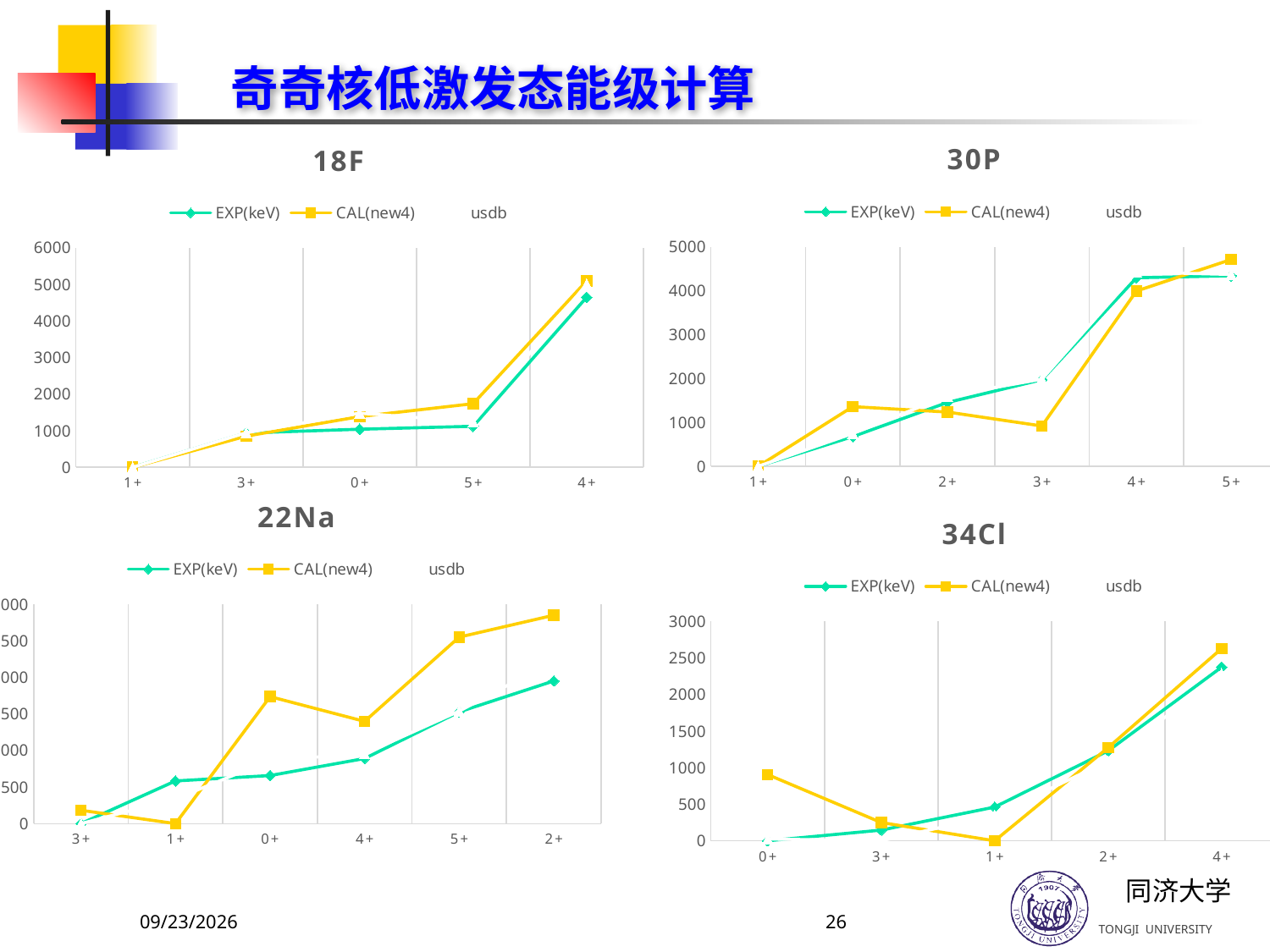
In the 18F chart, is the EXP(keV) value at 4+ greater or less than 4000? greater What kind of chart is the 18F chart? line chart In the 30P chart, at which category does the CAL(new4) series reach its highest value? 5+ In the 22Na chart, at which category does the CAL(new4) series reach its lowest value? 1+ In the 30P chart, which series has the larger value at 0+, EXP(keV) or CAL(new4)? CAL(new4) In the 30P chart, how many categories are on the x axis? 6 In the 18F chart, how many categories are on the x axis? 5 How many charts are shown on the slide? 4 In the 18F chart, at which category does the EXP(keV) series reach its highest value? 4+ In the 34Cl chart, which series has the larger value at 0+, EXP(keV) or CAL(new4)? CAL(new4) In the 34Cl chart, is the EXP(keV) value at 4+ greater or less than 2000? greater